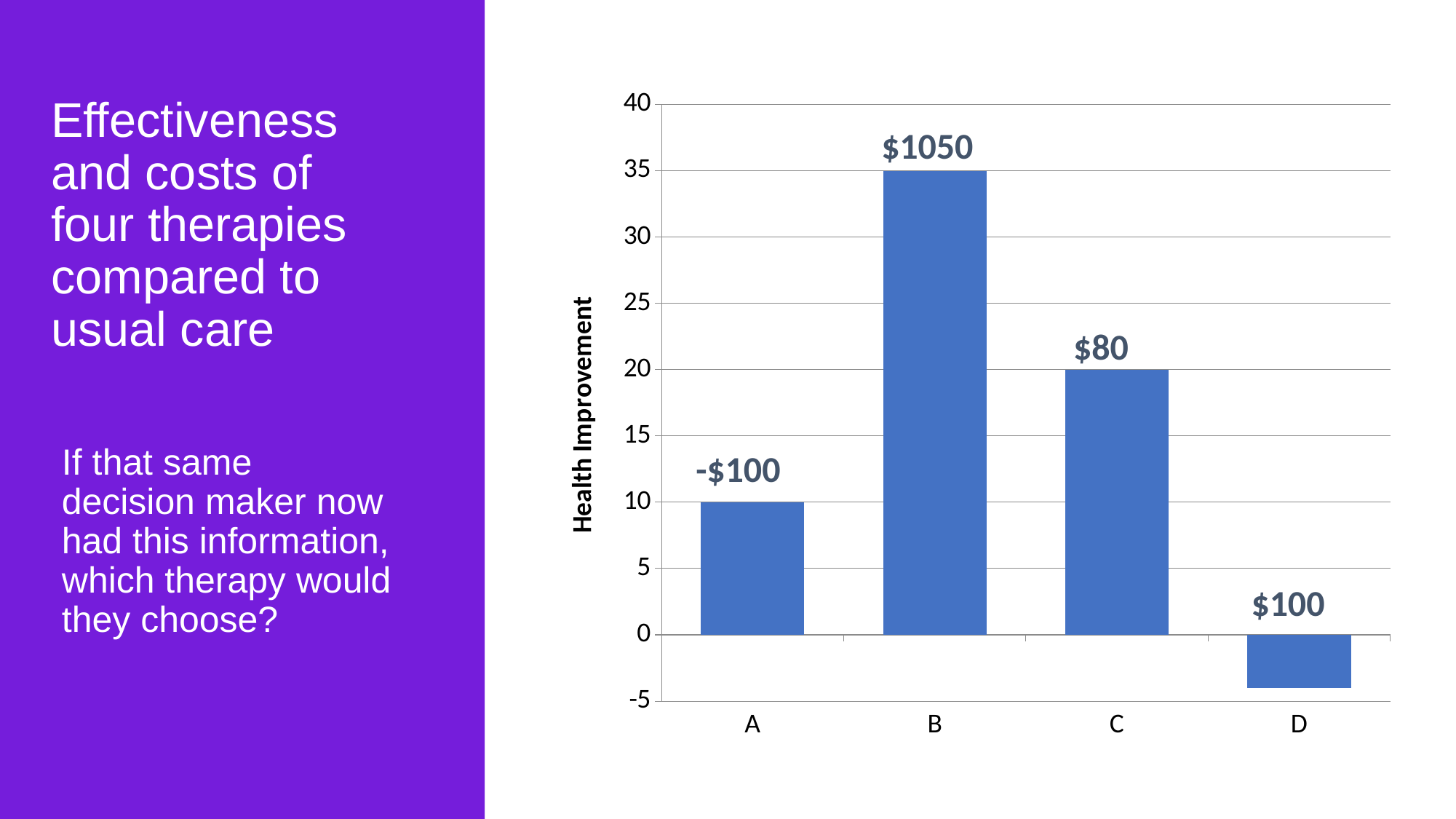
How many therapies (categories) are plotted on the chart? 4 Which therapy has the lowest health improvement? D What cost label is printed above the bar for therapy D? $100 What cost label is printed above the bar for therapy B? $1050 What cost label is printed above the bar for therapy A? -$100 Which therapy has the highest health improvement? B Which therapy has a larger health improvement, A or C? C Is the health improvement for therapy D greater or less than 0? less What cost label is printed above the bar for therapy C? $80 Is the health improvement for therapy B greater or less than 30? greater What type of chart is shown on the slide? bar chart What is the label on the vertical axis of the chart? Health Improvement